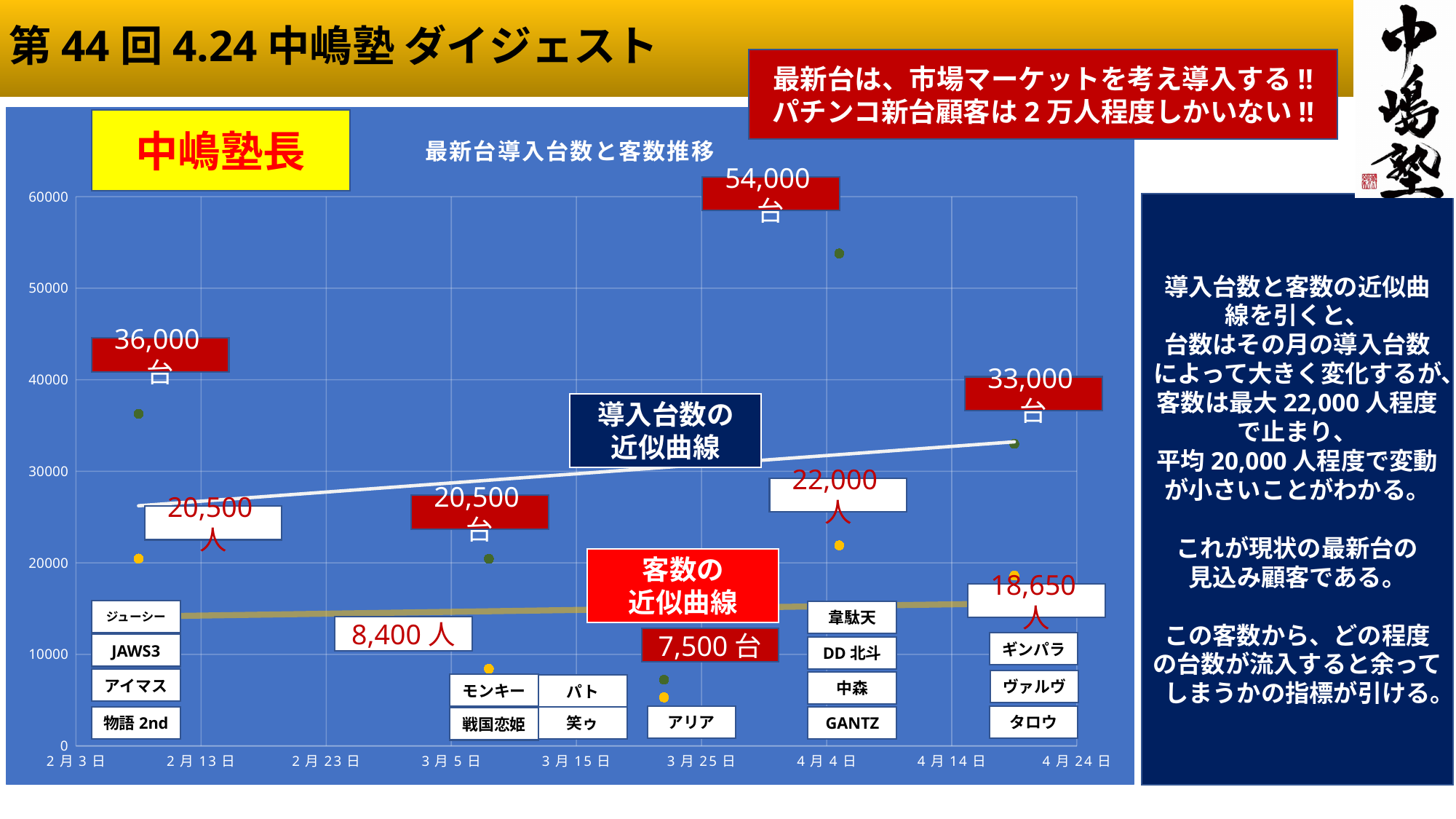
Which is larger, the 導入台数 labelled for the February group (ジューシー, JAWS3, アイマス, 物語2nd) or for the late-April group (ギンパラ, ヴァルヴ, タロウ)? February group (36,000台) What is the lowest labelled 客数 value on the chart? 8,400人 What is the 導入台数 value labelled for the group including 韋駄天, DD北斗, 中森 and GANTZ? 54,000台 What is the difference between the 22,000人 and 18,650人 labelled 客数 values? 3,350人 What is the highest labelled 客数 value on the chart? 22,000人 What kind of chart is shown on the slide? scatter chart What is the title of the chart? 最新台導入台数と客数推移 What is the difference between the 54,000台 and 33,000台 labelled values? 21,000台 Does the 導入台数の近似曲線 (white trend line) rise or fall from left to right? rise What is the highest labelled 導入台数 value on the chart? 54,000台 What is the lowest labelled 導入台数 value on the chart? 7,500台 What is the 客数 value labelled for the group including ギンパラ, ヴァルヴ and タロウ? 18,650人